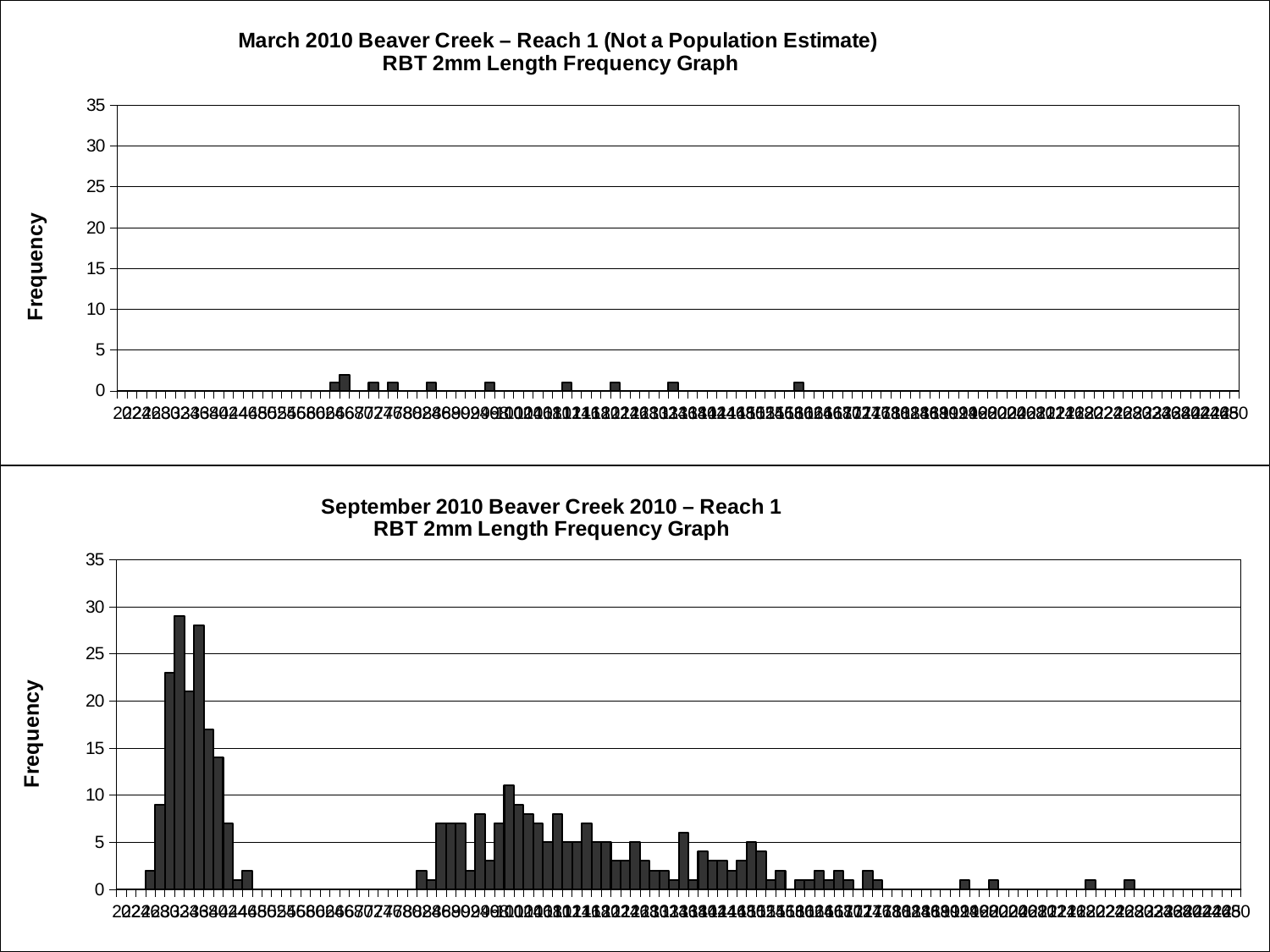
What is the label on the vertical axis of the top chart (March 2010)? Frequency In the top chart (March 2010), are all the bars greater or less than 5? less What is the highest tick value shown on the vertical axis of the bottom chart (September 2010)? 35 What kind of chart is the bottom chart, titled "September 2010 Beaver Creek 2010 – Reach 1"? Bar chart In the top chart (March 2010), is the tallest bar greater or less than 5? less In the bottom chart (September 2010), is the tallest bar greater or less than 25? greater What kind of chart is the top chart, titled "March 2010 Beaver Creek – Reach 1 (Not a Population Estimate)"? Bar chart Which chart has the taller maximum bar, the top chart (March 2010) or the bottom chart (September 2010)? The bottom chart (September 2010)